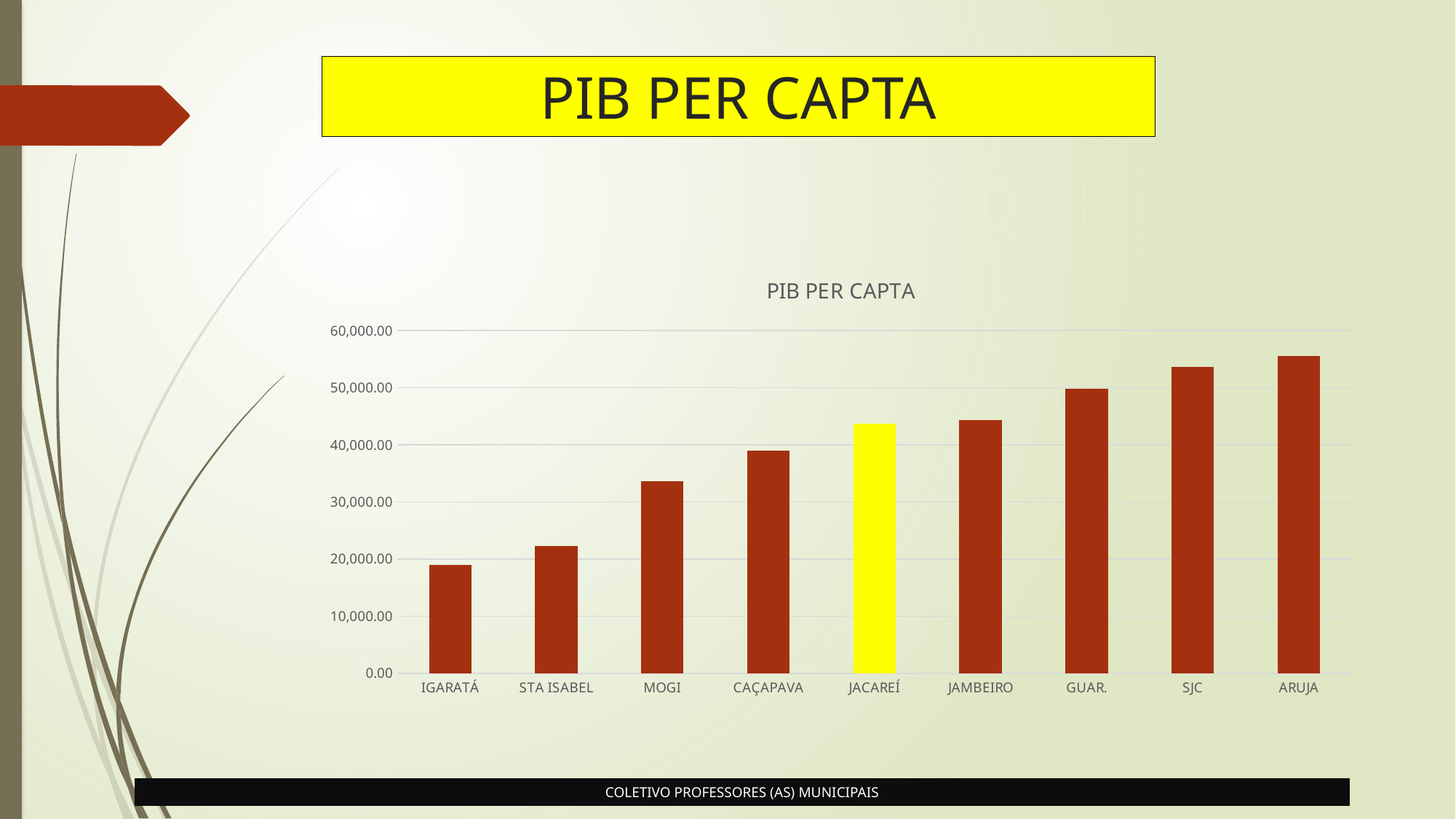
Which has a higher PIB per capta, MOGI or CAÇAPAVA? CAÇAPAVA What kind of chart is shown on the slide? bar chart Is the value for IGARATÁ greater or less than 20,000.00? less Is the value for MOGI greater or less than 30,000.00? greater Is the value for ARUJA greater or less than 60,000.00? less Which municipality has the lowest PIB per capta in the chart? IGARATÁ Which municipality's bar is highlighted in yellow in the chart? JACAREÍ Which municipality has the highest PIB per capta in the chart? ARUJA Do the bar values rise or fall from left to right along the x axis? rise How many municipalities are shown on the x axis of the chart? 9